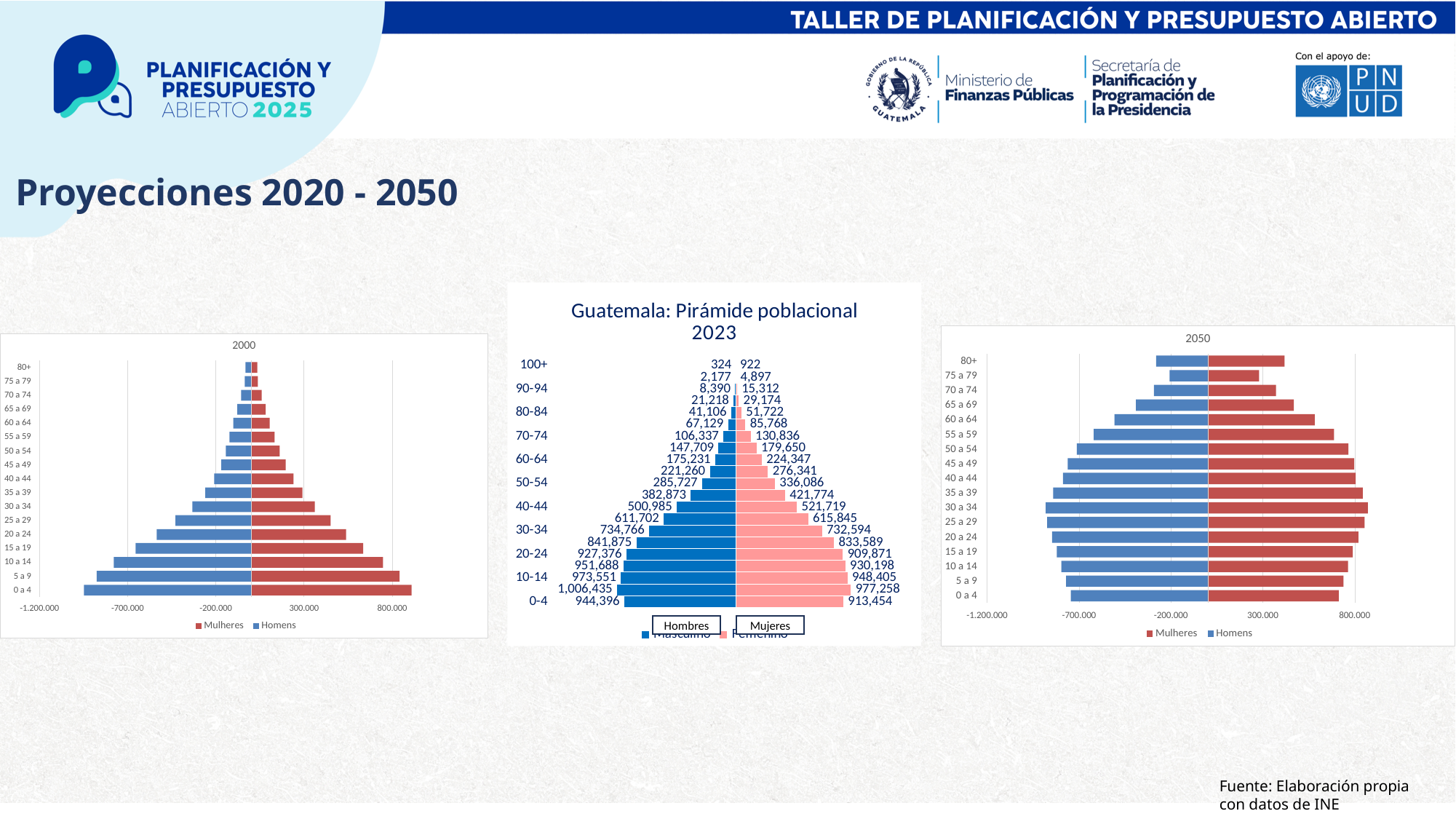
In the 'Guatemala: Pirámide poblacional 2023' chart, what is the Hombres value for the 0-4 age group? 944,396 In the 'Guatemala: Pirámide poblacional 2023' chart, what is the difference between the Hombres and Mujeres values for the 0-4 age group? 30,942 How many series does the legend of the '2050' chart on the right list? 2 In the 'Guatemala: Pirámide poblacional 2023' chart, what is the Hombres value for the 60-64 age group? 175,231 In the 'Guatemala: Pirámide poblacional 2023' chart, which is larger for the 20-24 age group, Hombres or Mujeres? Hombres In the 'Guatemala: Pirámide poblacional 2023' chart, what is the Mujeres value for the 100+ age group? 922 In the 'Guatemala: Pirámide poblacional 2023' chart, what is the difference between the Mujeres and Hombres values for the 100+ age group? 598 In the '2000' chart on the left, is the Mulheres value for 0 a 4 greater or less than 800.000? greater In the 'Guatemala: Pirámide poblacional 2023' chart, what is the Mujeres value for the 40-44 age group? 521,719 How many age-group categories does the '2000' chart on the left show? 17 In the 'Guatemala: Pirámide poblacional 2023' chart, which is larger for the 60-64 age group, Hombres or Mujeres? Mujeres In the 'Guatemala: Pirámide poblacional 2023' chart, what is the Mujeres value for the 0-4 age group? 913,454